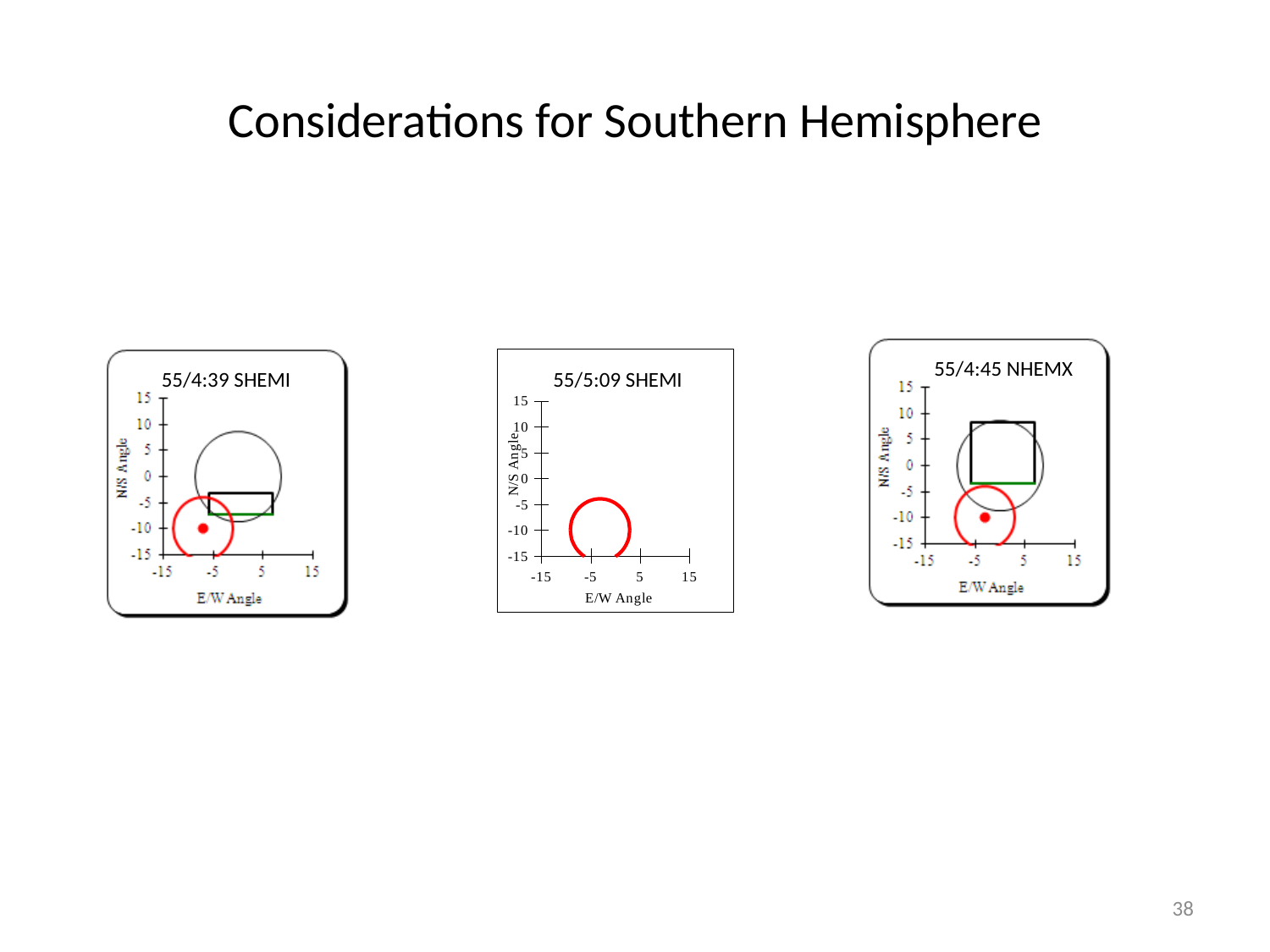
In the 55/4:45 NHEMX chart, is the N/S Angle of the red dot greater or less than -5? less What is the title of the rightmost chart on the slide? 55/4:45 NHEMX In the 55/4:39 SHEMI chart, is the E/W Angle of the red dot greater or less than 0? less How many charts are shown on the slide? 3 In the 55/4:39 SHEMI chart, is the N/S Angle of the red dot greater or less than 0? less What is the title of the leftmost chart on the slide? 55/4:39 SHEMI In the 55/5:09 SHEMI chart, what is the highest tick value shown on the N/S Angle axis? 15 In the 55/4:39 SHEMI chart, which is higher on the N/S Angle axis: the red dot or the green line? the green line In the 55/4:45 NHEMX chart, which is higher on the N/S Angle axis: the red dot or the top edge of the black rectangle? the top edge of the black rectangle In the 55/4:39 SHEMI chart, what is the lowest tick value shown on the E/W Angle axis? -15